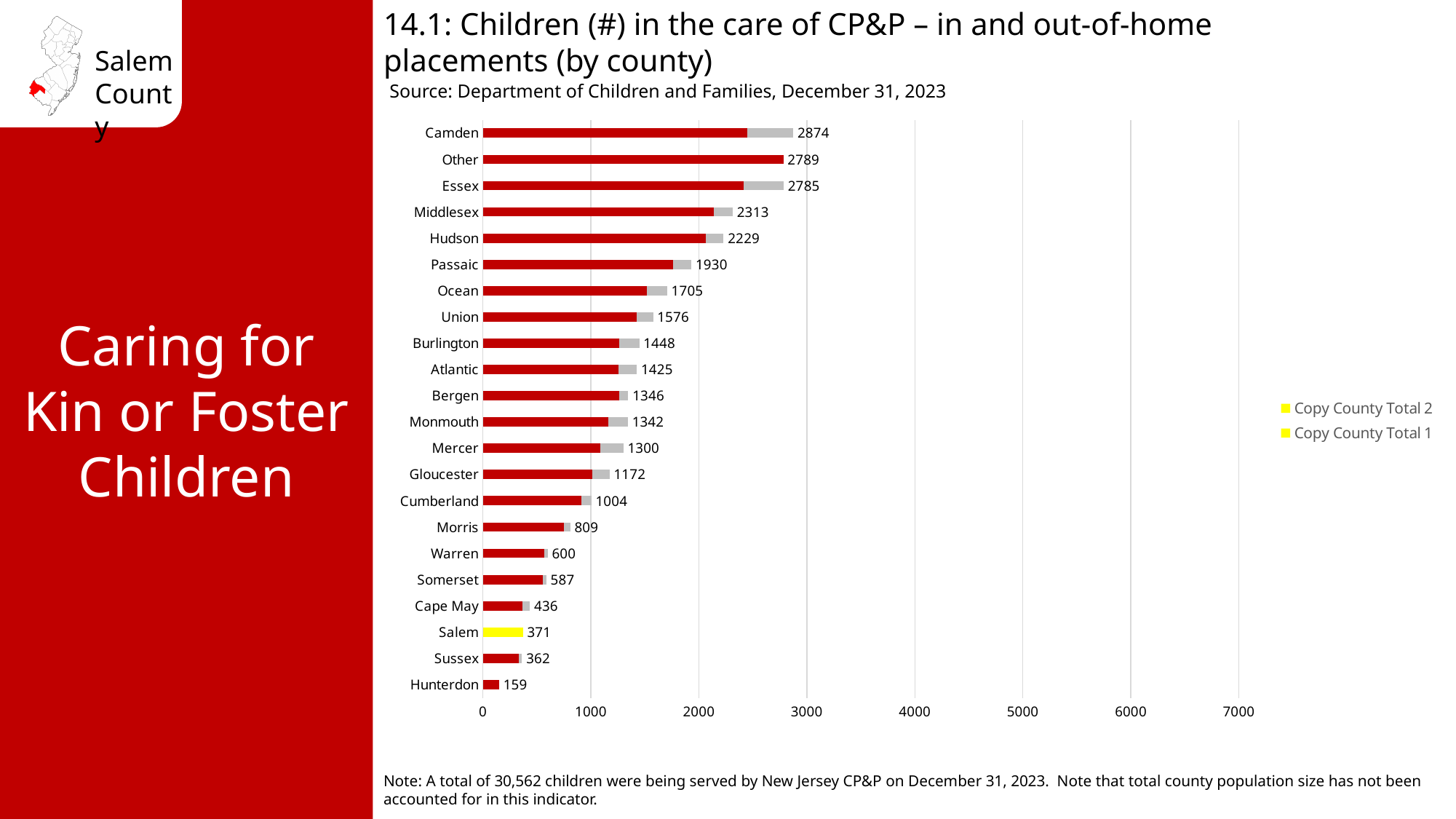
What value is labelled for Gloucester? 1172 How many series does the legend list? 2 How many counties (categories) are listed on the chart? 22 Which county has the lowest labelled total on the chart? Hunterdon What value is labelled for Salem on the chart? 371 What is the difference between the labelled totals for Camden and Other? 85 What is the difference between the labelled totals for Salem and Sussex? 9 What is the total number of children in the care of CP&P shown for Camden? 2874 Is the total bar for Salem greater or less than 1000? less What kind of chart is shown on the slide? Bar chart Which county has the highest labelled total on the chart? Camden Which has a larger labelled total, Passaic or Ocean? Passaic